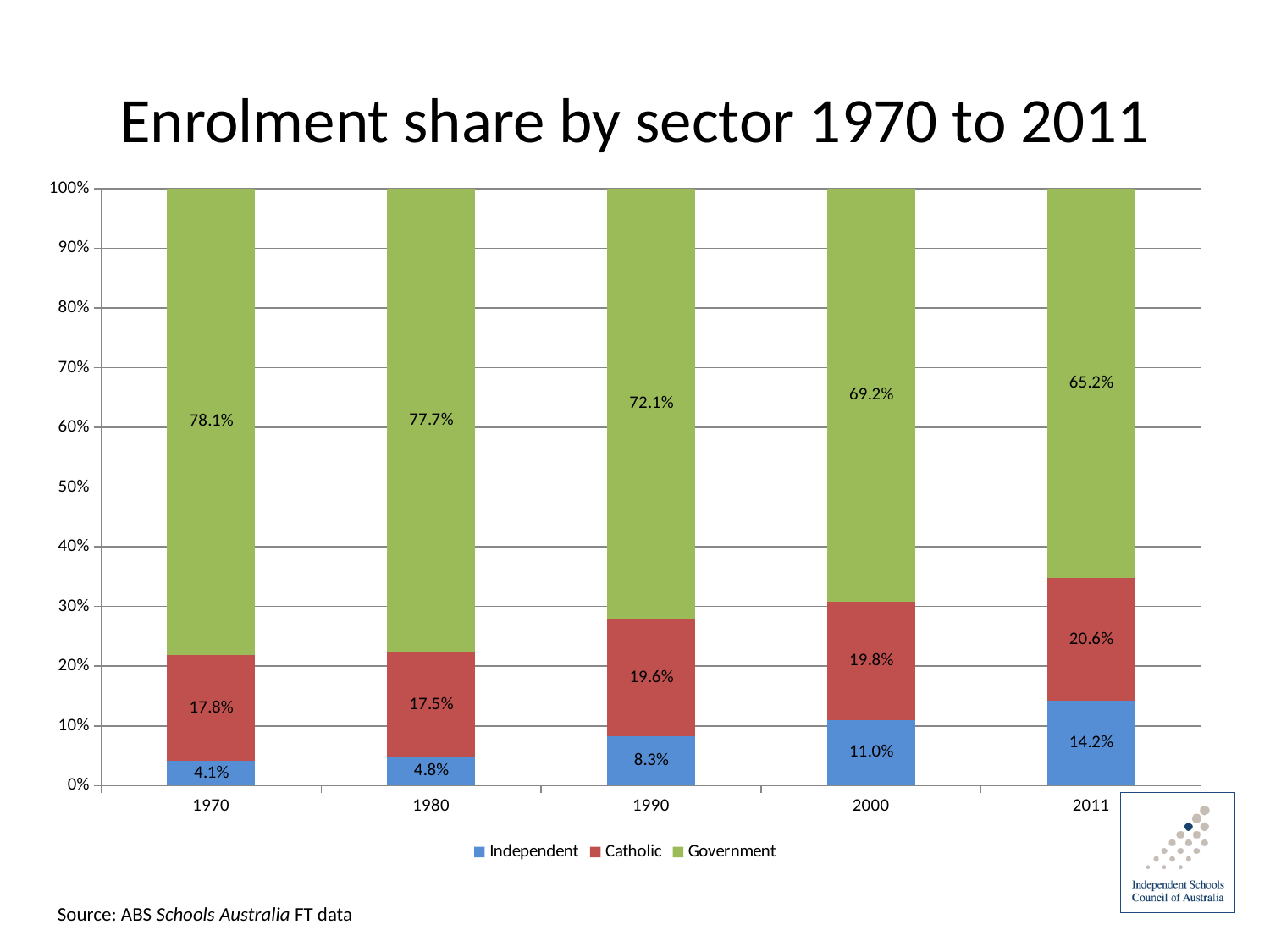
What is the Government enrolment share in 1970? 78.1% How many series does the legend list? 3 Does the Independent share rise or fall from 1970 to 2011? Rise What is the Independent enrolment share in 2011? 14.2% What is the Catholic enrolment share in 1990? 19.6% In which year is the Independent share the lowest? 1970 How many years are shown on the x axis? 5 Which is larger, the Catholic share in 2000 or the Catholic share in 2011? 2011 What kind of chart is shown on the slide? Stacked bar chart In which year is the Government share the highest? 1970 What is the difference between the Government share in 1970 and in 2011? 12.9% Which colour represents the Government series in the chart? Green